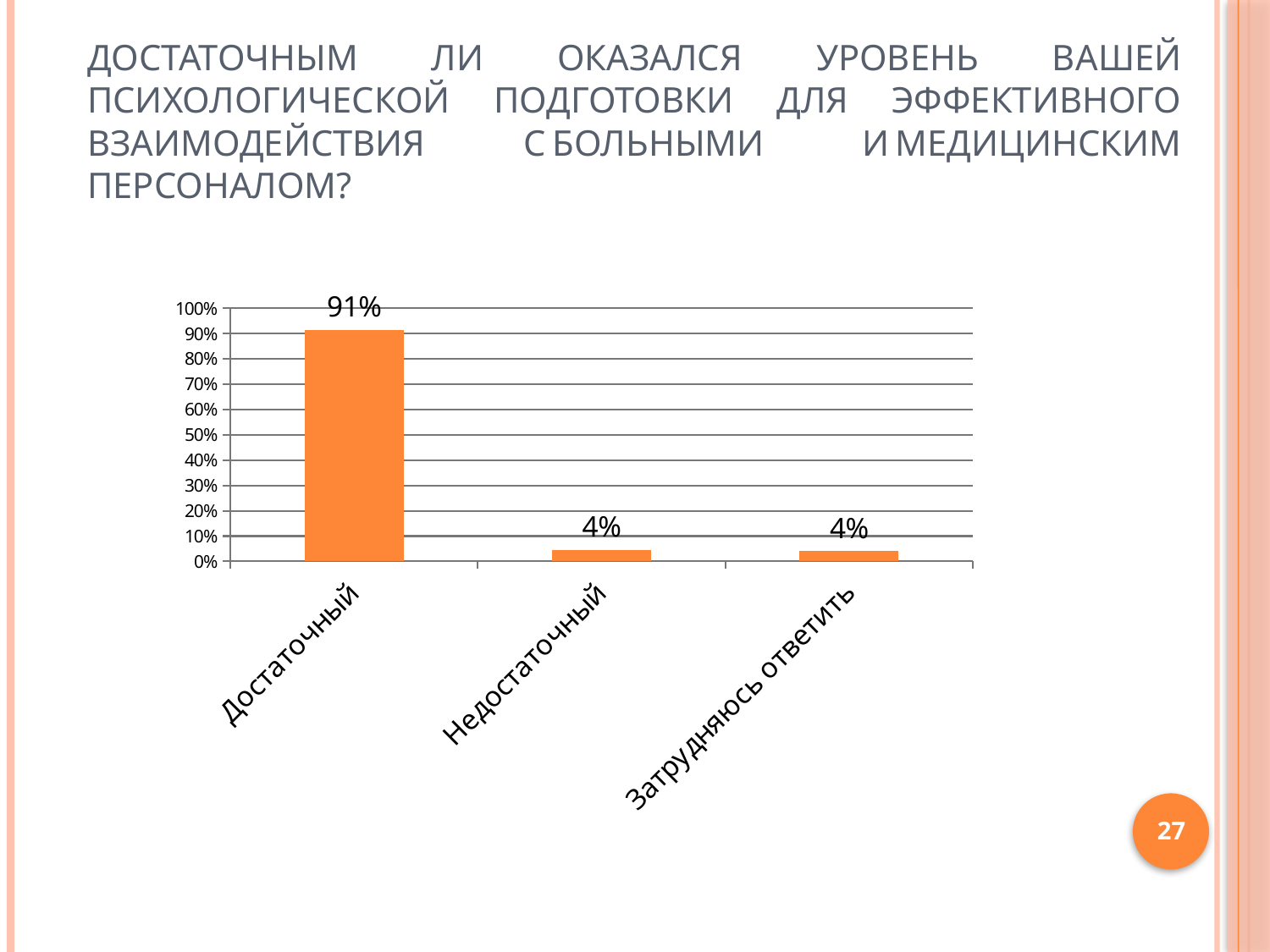
How many categories are shown on the x axis? 3 What kind of chart is shown on the slide? bar chart What is the value for Затрудняюсь ответить? 4% What is the value for Достаточный? 91% Which is larger, the value for Достаточный or the value for Затрудняюсь ответить? Достаточный What is the value for Недостаточный? 4% What colour are the bars in the chart? orange Which category has the highest value? Достаточный What is the difference between the values for Достаточный and Недостаточный? 87% Is the value for Достаточный greater or less than 50%? greater What is the highest tick value shown on the y axis? 100% Is the value for Недостаточный greater or less than 10%? less